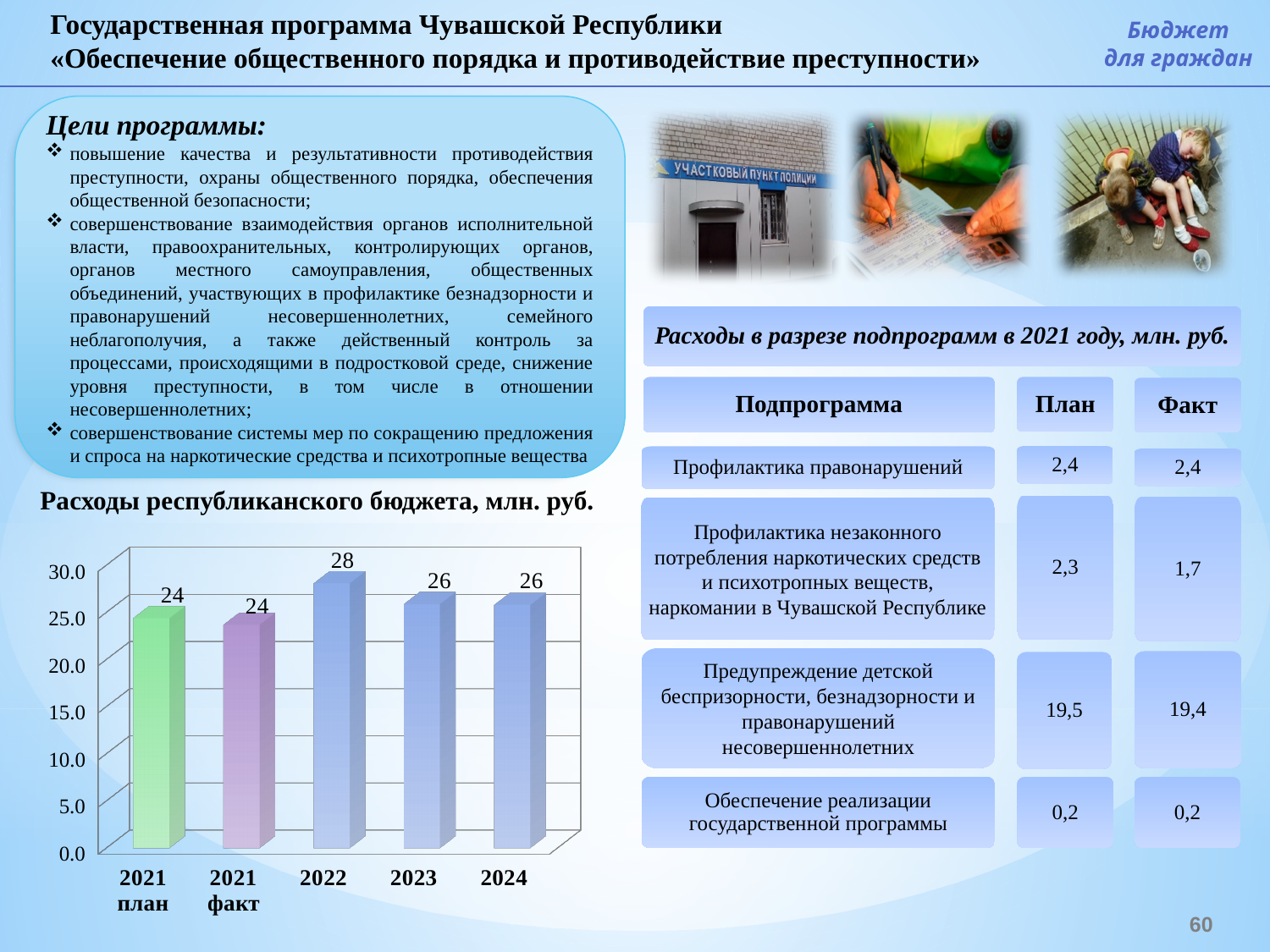
What is the title of the chart on the slide? Расходы республиканского бюджета, млн. руб. What is the value for 2024 in the chart? 26 Which category has the highest value in the chart? 2022 What is the difference between the values for 2022 and 2021 факт in the chart? 4 Which is larger in the chart, the value for 2022 or the value for 2024? 2022 What kind of chart is shown on the slide? bar chart What is the value for 2022 in the chart "Расходы республиканского бюджета, млн. руб."? 28 How many categories are shown on the x axis of the chart? 5 What is the difference between the values for 2022 and 2023 in the chart? 2 Is the value for 2021 факт in the chart greater or less than 25.0? less Is the value for 2022 in the chart greater or less than 25.0? greater What is the value for 2021 план in the chart? 24